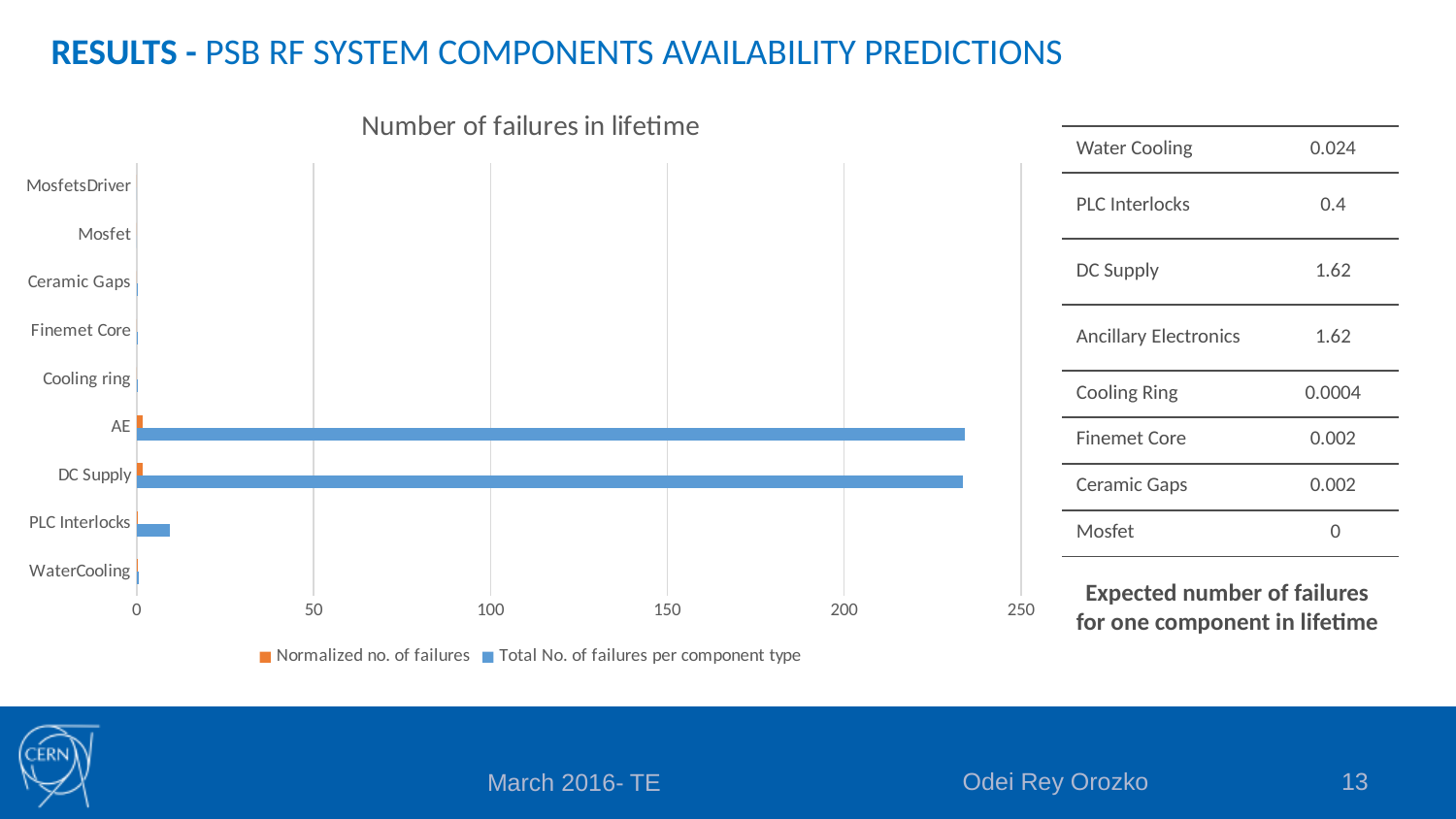
Is the Total No. of failures per component type for WaterCooling greater or less than 50? less Is the Total No. of failures per component type for PLC Interlocks greater or less than 50? less How many series does the chart legend list? 2 What is the title of the chart? Number of failures in lifetime Is the Total No. of failures per component type for DC Supply greater or less than 200? greater Which has a larger Total No. of failures per component type, DC Supply or WaterCooling? DC Supply Which colour represents the Normalized no. of failures series in the chart? orange What kind of chart is shown on the slide? bar chart What is the highest value shown on the chart's horizontal axis? 250 Which has a larger Total No. of failures per component type, AE or PLC Interlocks? AE How many component categories are shown on the chart's vertical axis? 9